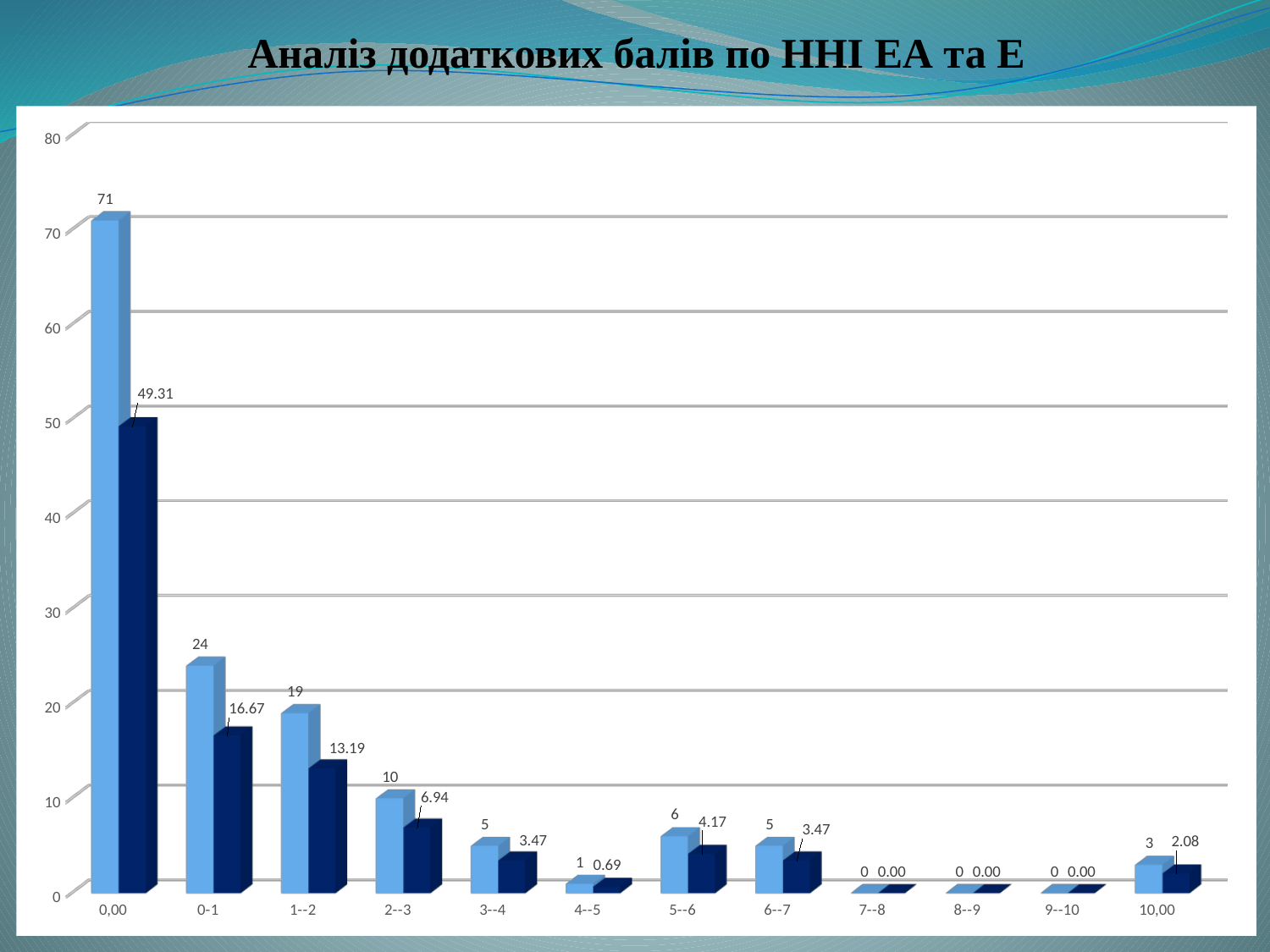
What is the difference between the light blue bars for 0-1 and 1--2? 5 What is the value of the dark blue bar for the category 0,00? 49.31 Which category has the highest light blue bar? 0,00 How many categories are shown on the x axis? 12 What is the value of the light blue bar for the category 10,00? 3 Do the light blue bars rise or fall from the category 0,00 to the category 4--5? fall What is the value of the dark blue bar for the category 1--2? 13.19 What is the value of the light blue bar for the category 0,00? 71 Which is larger, the light blue bar for 5--6 or the light blue bar for 6--7? 5--6 What kind of chart is shown on the slide? bar chart What is the title of the chart? Аналіз додаткових балів по ННІ ЕА та Е Is the value of the light blue bar for 0,00 greater or less than 60? greater